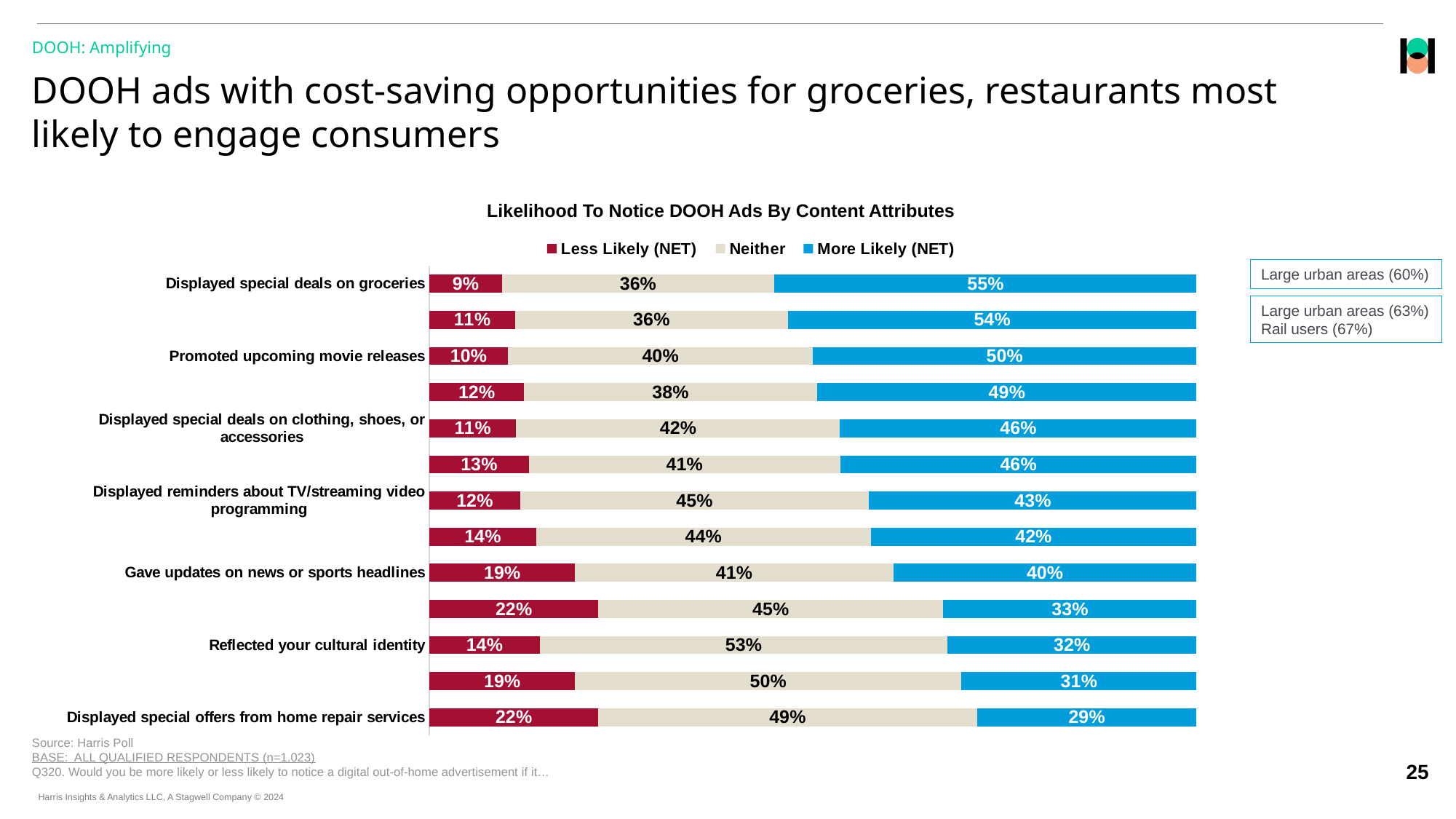
What kind of chart is shown on the slide? Stacked bar chart What is the title of the chart? Likelihood To Notice DOOH Ads By Content Attributes Which labeled category has the lowest More Likely (NET) value? Displayed special offers from home repair services What is the difference between the More Likely (NET) values for 'Displayed special deals on groceries' and 'Displayed special offers from home repair services'? 26 percentage points What is the Less Likely (NET) value for 'Displayed special offers from home repair services'? 22% Which has a larger Neither value: 'Reflected your cultural identity' or 'Gave updates on news or sports headlines'? Reflected your cultural identity What is the More Likely (NET) value for 'Promoted upcoming movie releases'? 50% What is the Neither value for 'Reflected your cultural identity'? 53% How many series does the legend list? 3 What is the total of the three segments in the bar for 'Displayed special deals on groceries'? 100% What is the More Likely (NET) value for 'Displayed special deals on groceries'? 55% Which labeled category has the highest More Likely (NET) value? Displayed special deals on groceries